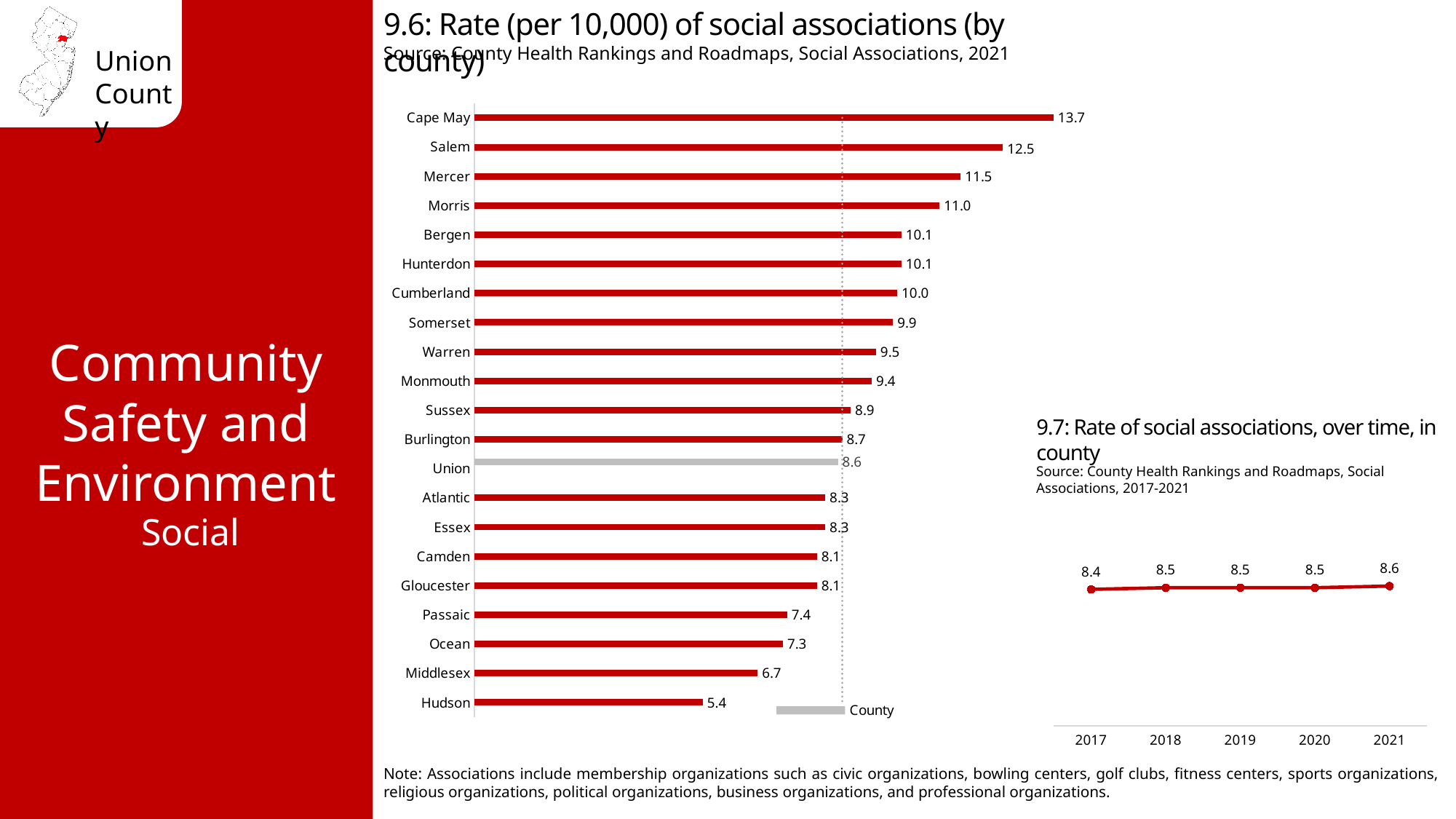
In chart 9.6, what is the difference between the rates for Salem and Middlesex? 5.8 In chart 9.7, does the rate of social associations rise or fall from 2017 to 2021? Rise In chart 9.6, which bar is shown in grey instead of red? Union What kind of chart is chart 9.6? Bar chart In chart 9.7, what was the rate of social associations in 2021? 8.6 In chart 9.6, what is the rate of social associations for Union? 8.6 In chart 9.6, what is the rate of social associations for Cape May? 13.7 In chart 9.7, what was the rate of social associations in 2017? 8.4 In chart 9.6, which county has the highest rate of social associations? Cape May How many counties are shown in chart 9.6? 21 In chart 9.6, which county has a higher rate, Mercer or Morris? Mercer In chart 9.6, which county has the lowest rate of social associations? Hudson